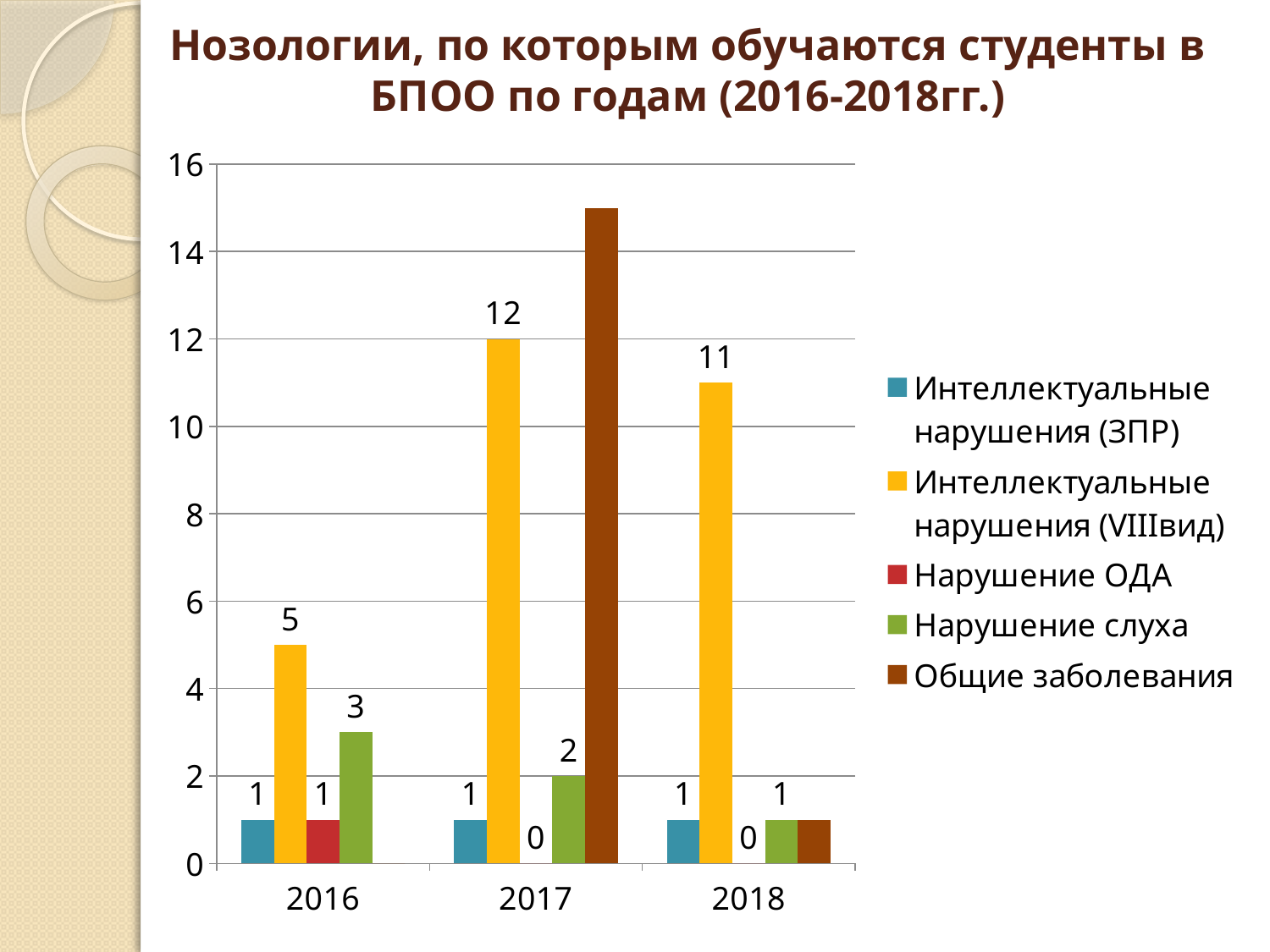
In which year is the value for Интеллектуальные нарушения (VIIIвид) the highest? 2017 What is the difference between the Интеллектуальные нарушения (VIIIвид) values for 2017 and 2018? 1 Does the value for Нарушение слуха rise or fall from 2016 to 2018? fall In 2016, which is larger: Интеллектуальные нарушения (VIIIвид) or Нарушение слуха? Интеллектуальные нарушения (VIIIвид) How many years are shown on the x axis? 3 What is the value for Интеллектуальные нарушения (VIIIвид) in 2017? 12 How many series does the legend list? 5 What kind of chart is shown on the slide? bar chart Is the value for Общие заболевания in 2017 greater or less than 14? greater What is the value for Нарушение ОДА in 2017? 0 What is the value for Интеллектуальные нарушения (VIIIвид) in 2018? 11 What is the value for Нарушение слуха in 2016? 3